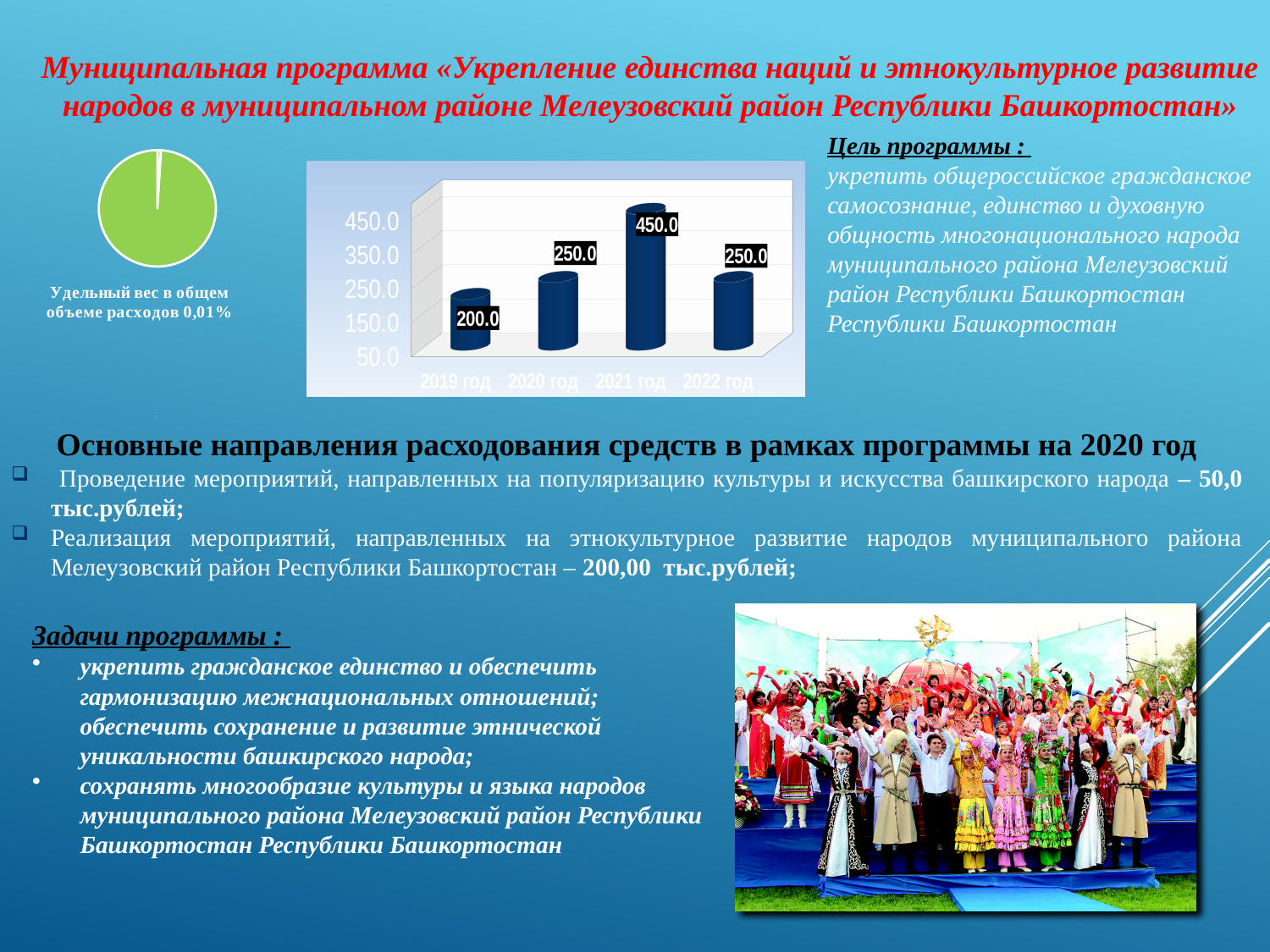
In the bar chart, which is larger, the value for 2020 год or the value for 2019 год? 2020 год In the bar chart, what is the difference between the values for 2021 год and 2019 год? 250.0 In the bar chart, which year has the lowest value? 2019 год What kind of chart is the chart in the middle of the slide showing values by year? bar chart How many years are shown on the x axis of the bar chart? 4 In the bar chart, which year has the highest value? 2021 год In the bar chart, what is the value for 2019 год? 200.0 In the bar chart, what is the difference between the values for 2020 год and 2019 год? 50.0 In the bar chart, is the value for 2021 год greater or less than 350.0? greater What kind of chart is the chart on the left of the slide with the caption 'Удельный вес в общем объеме расходов 0,01%'? pie chart In the bar chart, what is the value for 2022 год? 250.0 In the bar chart, what is the value for 2021 год? 450.0